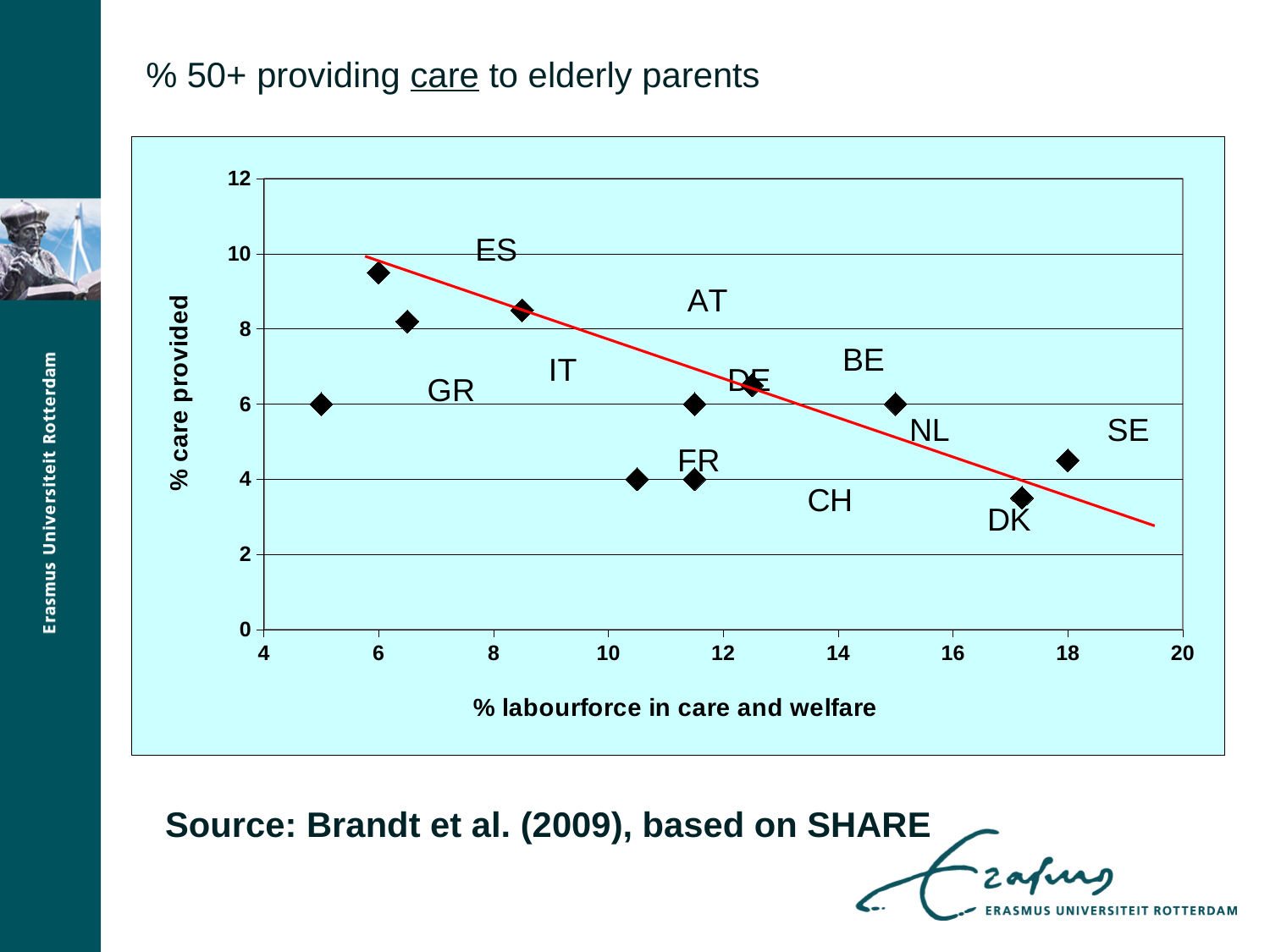
What is the title of the horizontal axis? % labourforce in care and welfare Which has a higher % care provided, SE or DK? SE Is the % care provided for SE greater or less than 6? less Is the % care provided for DK greater or less than 4? less How many country labels appear in the chart? 11 What is the maximum value shown on the vertical axis? 12 How many data points are plotted in the chart? 11 What kind of chart is shown on the slide? scatter chart Which country has the lowest % care provided? DK What is the title of the vertical axis? % care provided Does the red trend line rise or fall as % labourforce in care and welfare increases? fall Which country has the highest % labourforce in care and welfare? SE